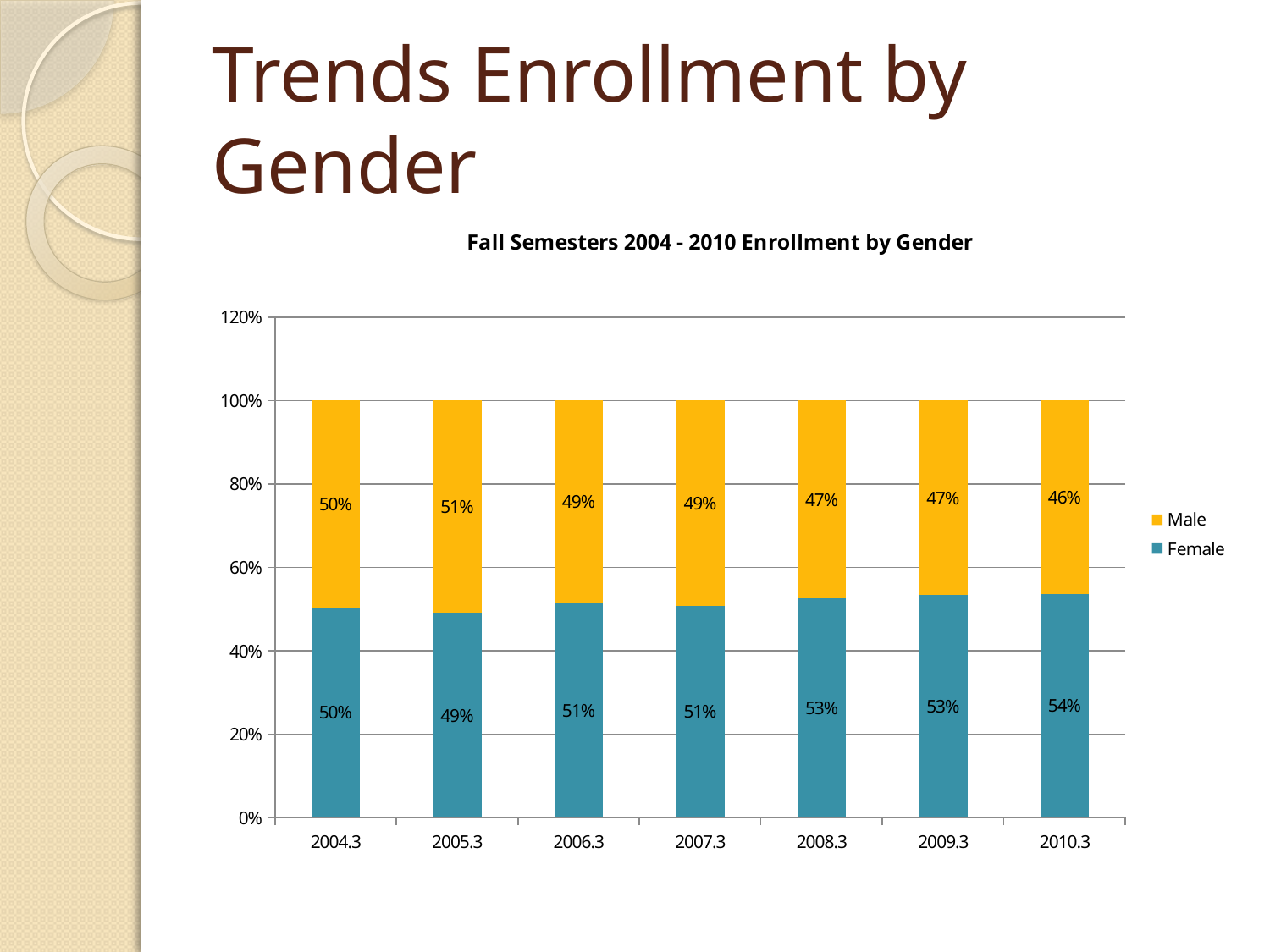
Which category has the lowest Male value? 2010.3 What is the Male value for 2010.3? 46% What kind of chart is shown? Stacked bar chart How many series does the legend list? 2 What is the Female value for 2004.3? 50% What is the Male value for 2005.3? 51% How many categories are shown on the x axis? 7 Which category has the highest Female value? 2010.3 Which is larger for 2005.3, the Male value or the Female value? Male Does the Female value rise or fall from 2004.3 to 2010.3? Rise What is the difference between the Female and Male values for 2010.3? 8% What is the Female value for 2008.3? 53%